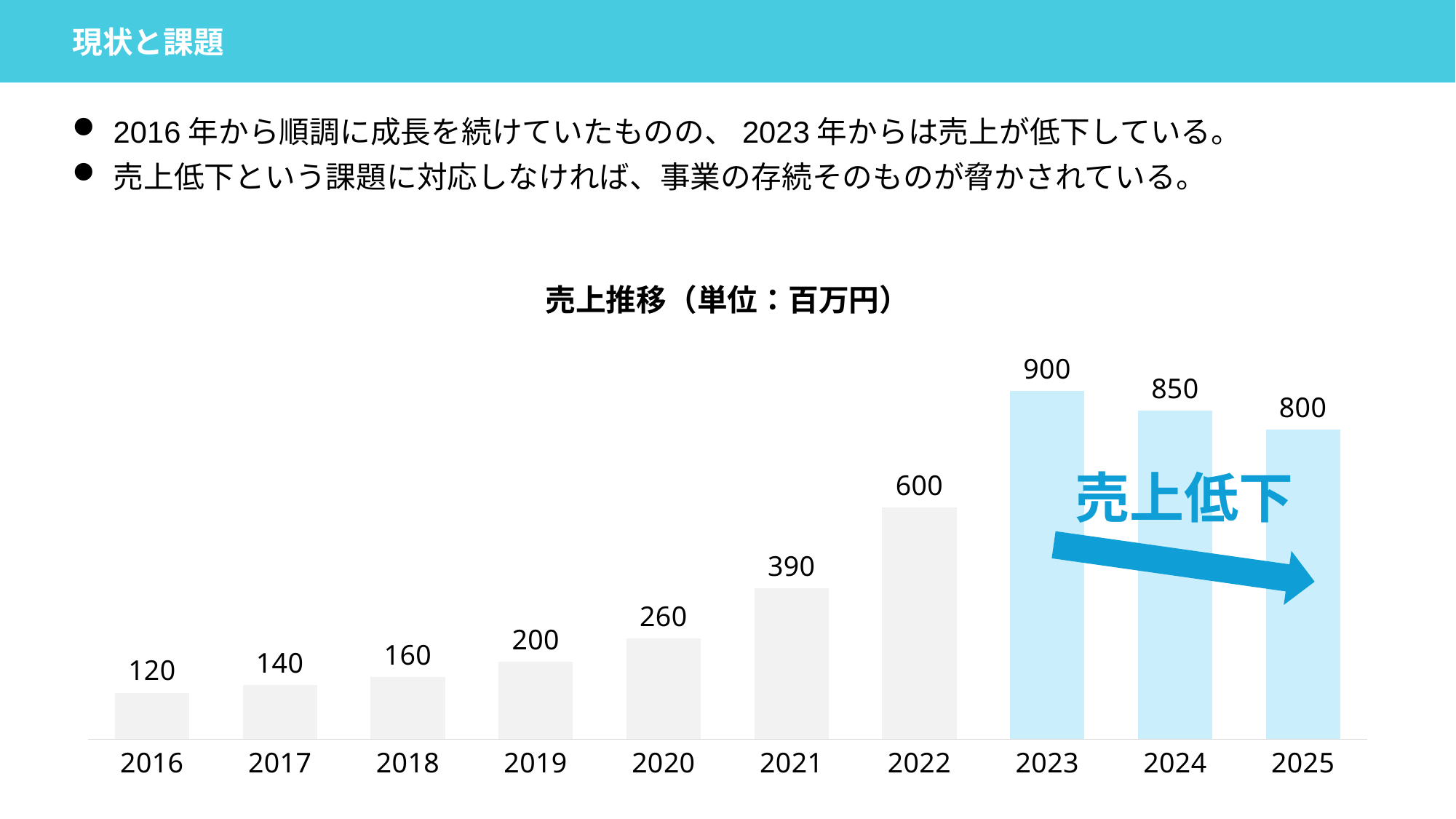
What kind of chart is this? bar chart Which year has the highest value? 2023 What is the value for 2016? 120 Do the values rise or fall from 2016 to 2022? rise What is the difference between the values for 2023 and 2025? 100 What is the difference between the values for 2022 and 2021? 210 How many years are shown on the x axis? 10 What is the title of the chart? 売上推移（単位：百万円） Which is larger, the value for 2024 or the value for 2022? 2024 Which year has the lowest value? 2016 What is the value for 2022? 600 What is the value for 2025? 800